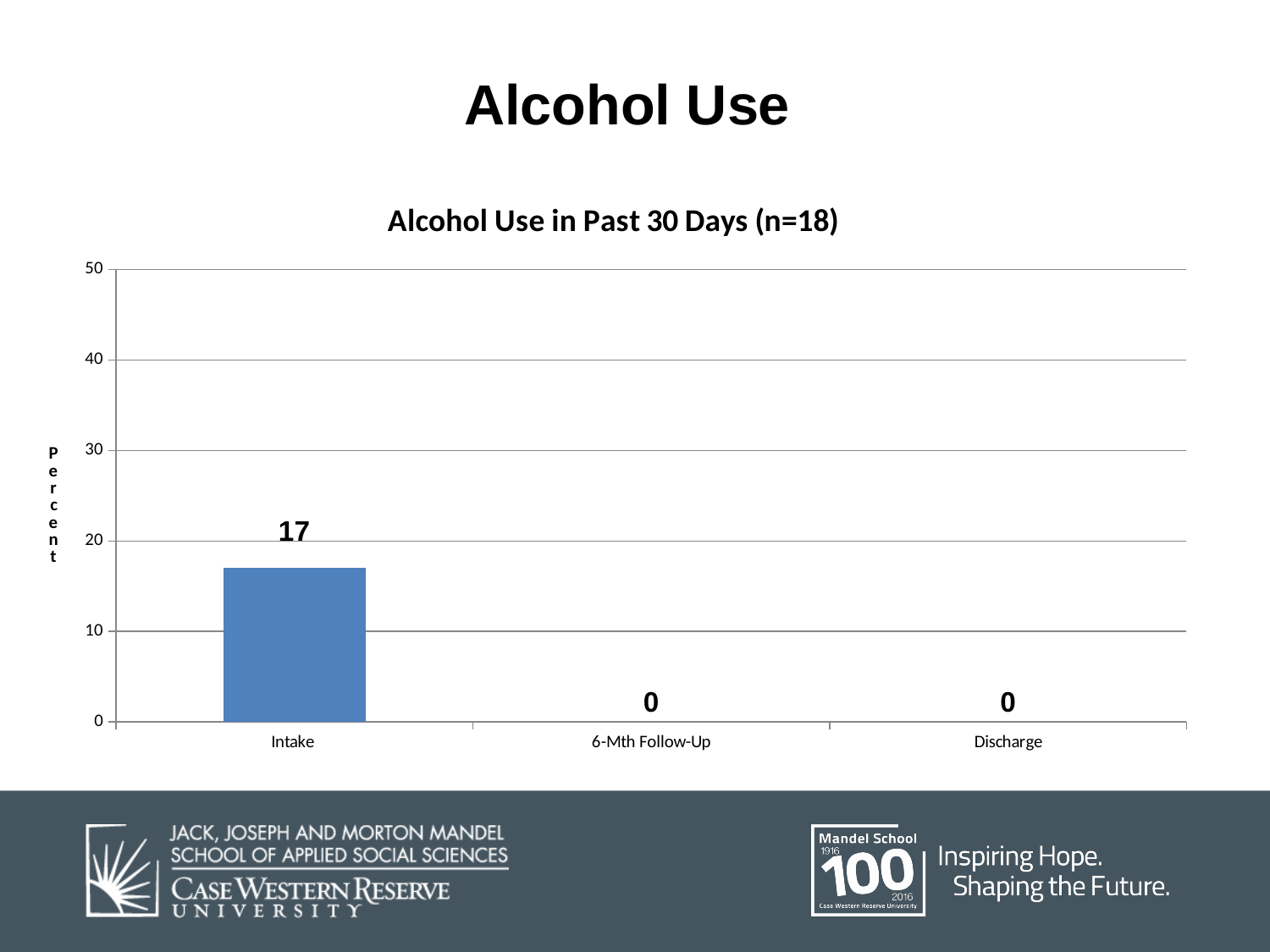
What is the label of the vertical axis? Percent How many categories are shown on the x axis? 3 What is the title of the chart? Alcohol Use in Past 30 Days (n=18) Which is larger, the value for Intake or the value for 6-Mth Follow-Up? Intake Is the value for Intake greater or less than 20? less Which category has the highest value? Intake What is the difference between the Intake value and the Discharge value? 17 What is the value for Intake? 17 What kind of chart is shown? bar chart Do the values rise or fall from Intake to Discharge? fall What is the value for Discharge? 0 What is the value for 6-Mth Follow-Up? 0